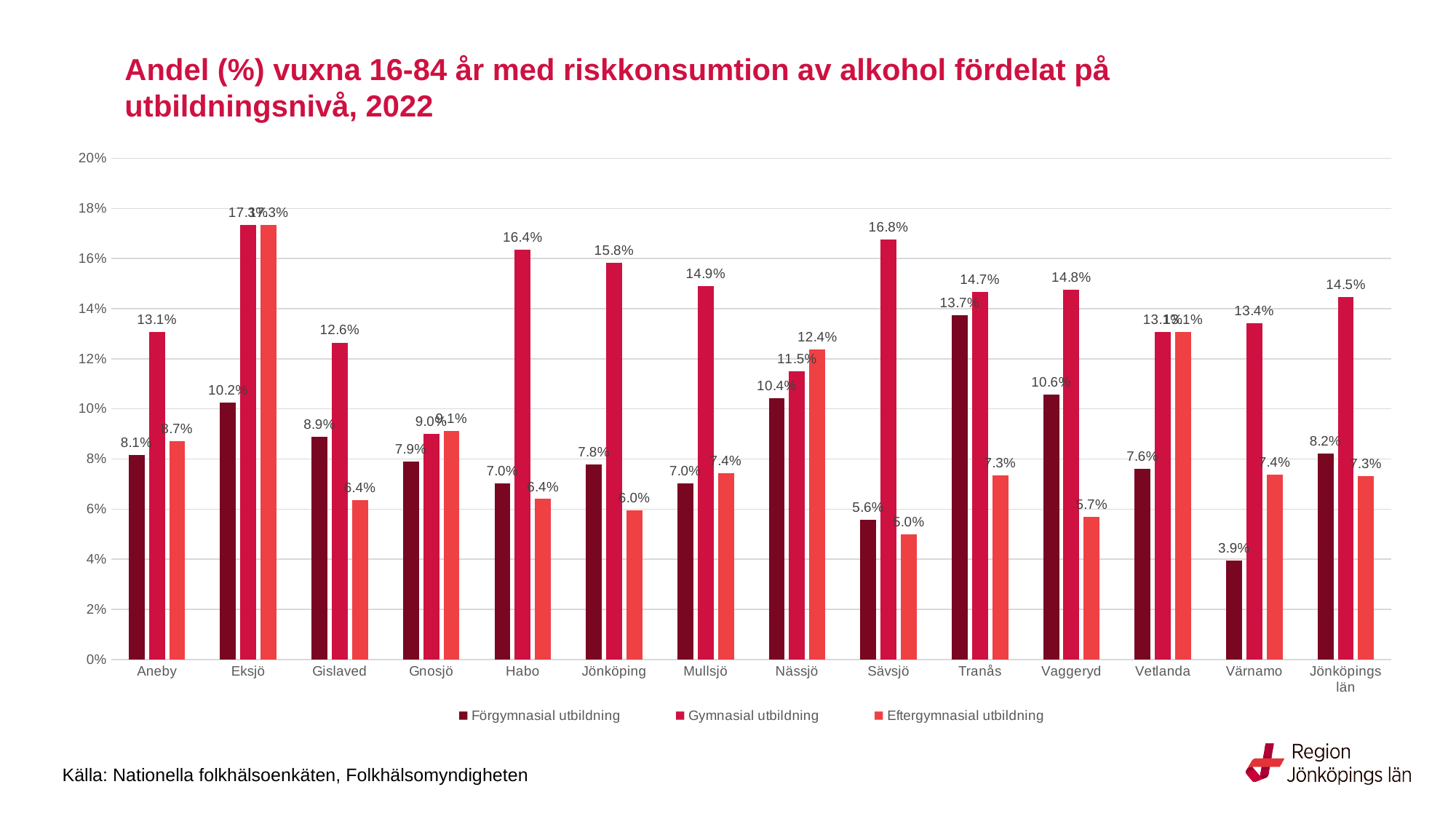
Which municipality has the lowest value for Förgymnasial utbildning? Värnamo What is the difference between the Gymnasial utbildning and Förgymnasial utbildning values in Sävsjö? 11.2% Which category has the lowest value for Eftergymnasial utbildning? Sävsjö How many categories are shown on the x axis? 14 What is the value for Förgymnasial utbildning in Tranås? 13.7% What is the value for Gymnasial utbildning in Jönköpings län? 14.5% Which is larger in Gnosjö: the value for Gymnasial utbildning or Eftergymnasial utbildning? Eftergymnasial utbildning What kind of chart is shown on the slide? Bar chart How many series does the legend list? 3 What is the value for Eftergymnasial utbildning in Nässjö? 12.4% Which category has the highest value for Gymnasial utbildning? Eksjö What is the value for Gymnasial utbildning in Habo? 16.4%